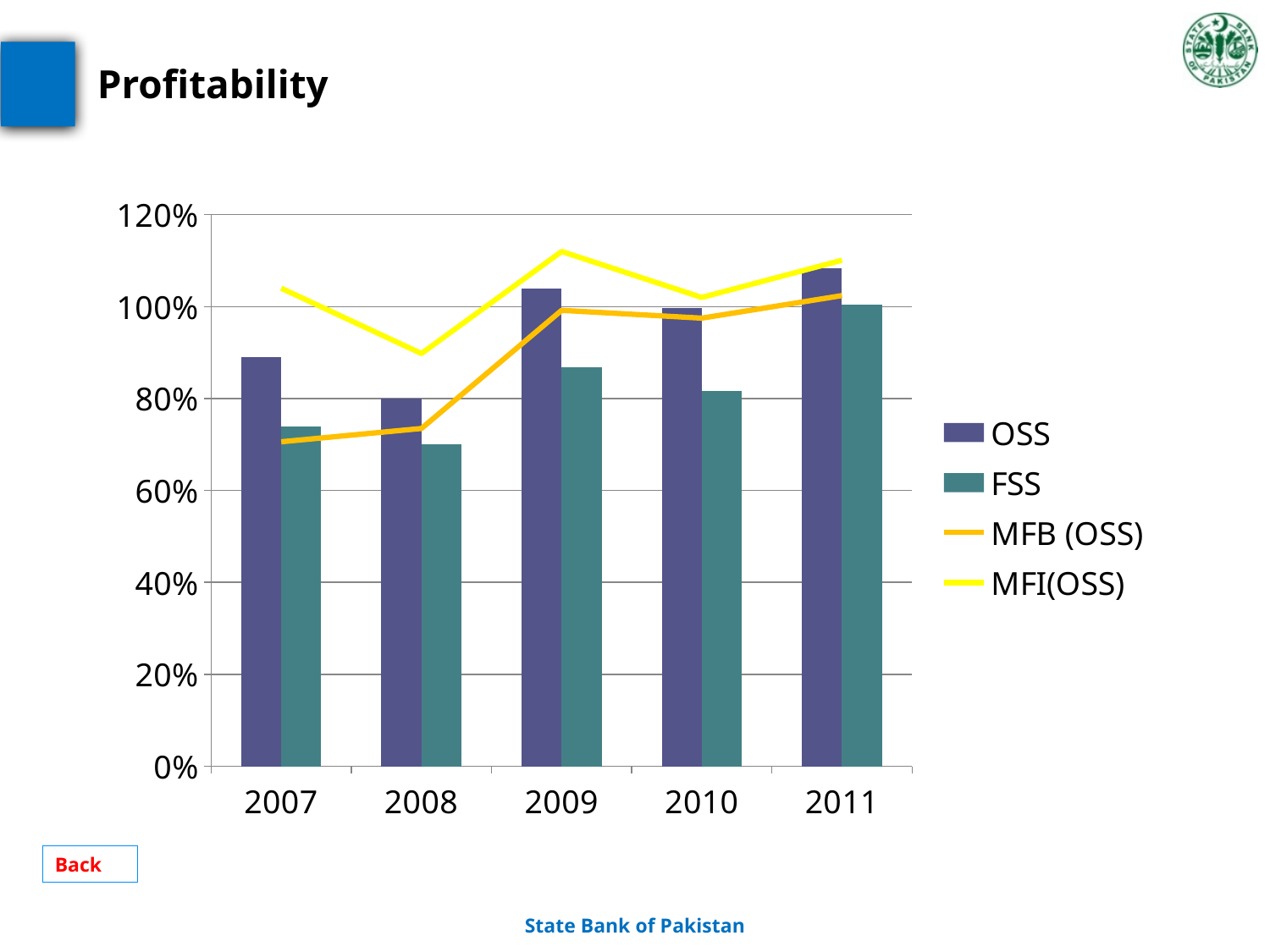
Is the OSS value for 2007 greater or less than 80%? greater In which year is the OSS bar highest? 2011 In which year is the OSS bar lowest? 2008 What kind of chart is shown on the slide? A bar chart combined with line series In which year is the FSS bar lowest? 2008 In which year is the FSS bar highest? 2011 How many series does the legend list? 4 What is the title of the slide containing the chart? Profitability Is the FSS value for 2008 greater or less than 80%? less In which year is the MFI(OSS) line at its lowest point? 2008 How many years are shown on the x axis? 5 In 2009, which is larger, the OSS bar or the FSS bar? OSS